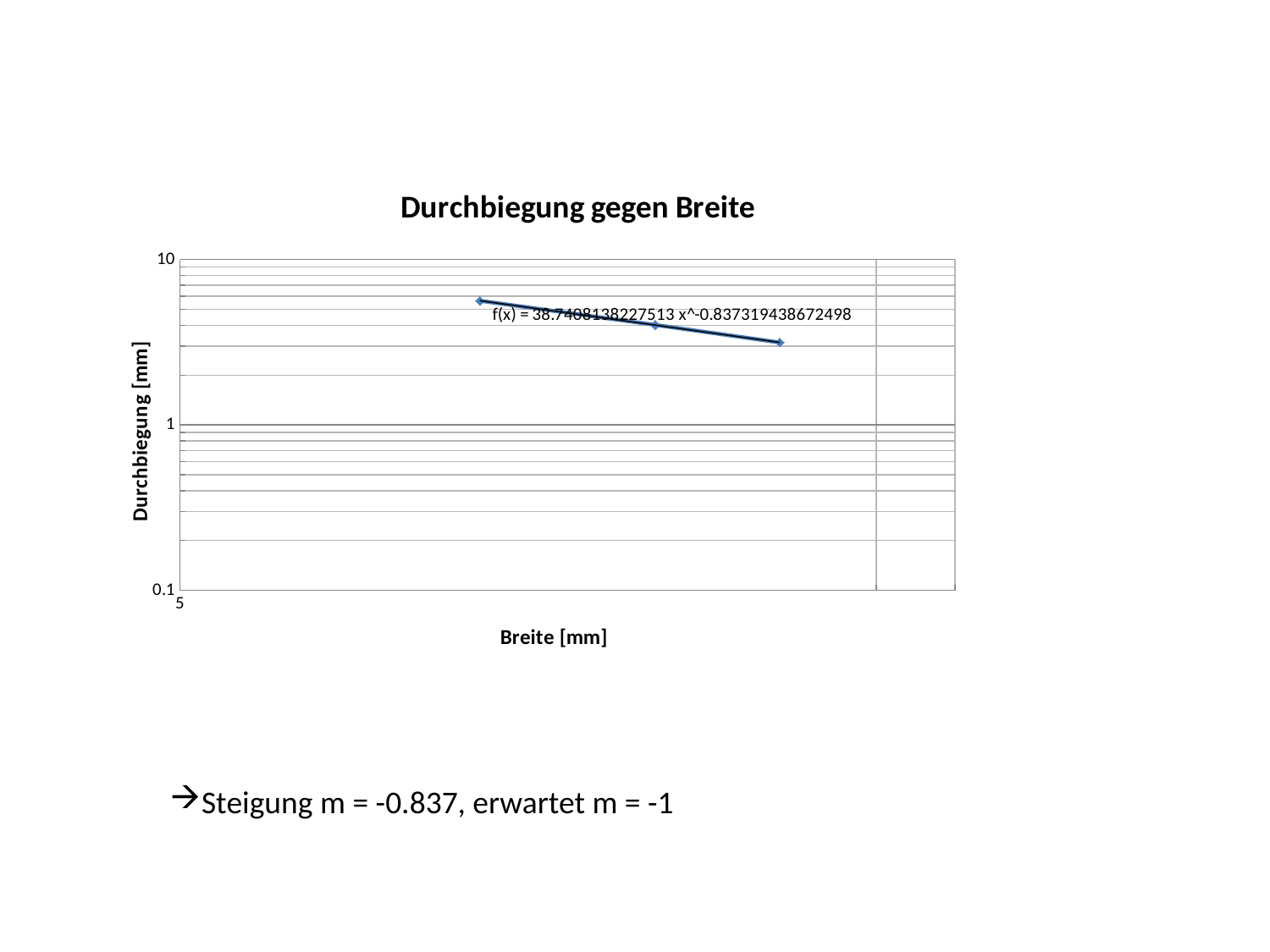
What kind of chart is shown on the slide? Scatter chart with a trendline Is the value of the rightmost data point greater or less than 10? less What is the exponent in the trendline equation shown on the chart? -0.837319438672498 Which data point has the highest Durchbiegung value, the leftmost or the rightmost? The leftmost Is the value of the leftmost data point greater or less than 1? greater Do the plotted values rise or fall as Breite increases along the x axis? Fall What is the coefficient in the trendline equation f(x) shown on the chart? 38.7408138227513 What is the label of the y axis? Durchbiegung [mm] What is the title of the chart? Durchbiegung gegen Breite How many data points are plotted in the chart? 3 Is the value of the rightmost data point greater or less than 1? greater Which data point has the lowest Durchbiegung value? The rightmost